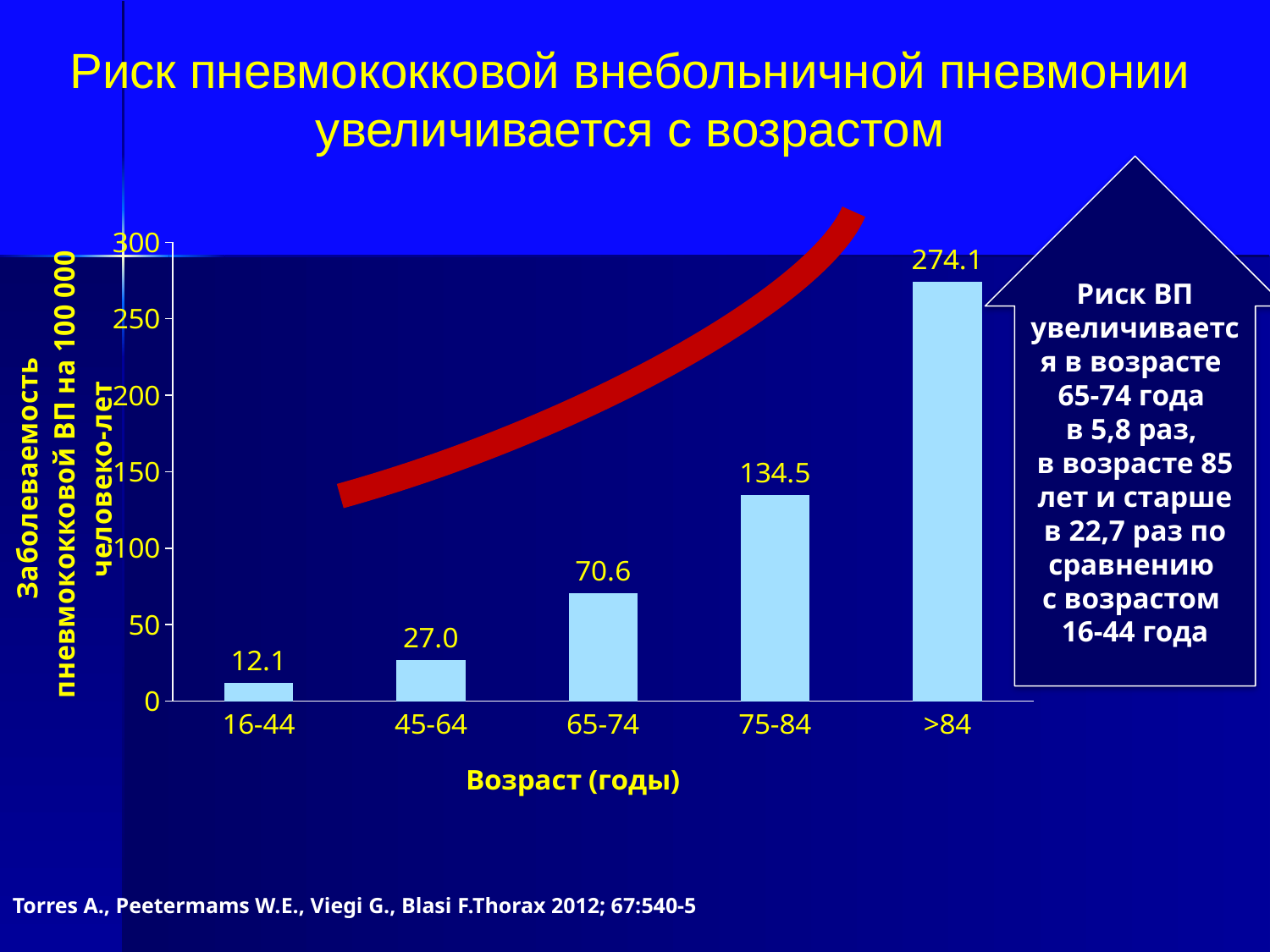
What is the difference between the values for 75-84 and 65-74? 63.9 Which age group has the highest value? >84 Which age group has the lowest value? 16-44 Do the values rise or fall as age increases along the x axis? rise What is the value for the 16-44 age group? 12.1 What is the value for the >84 age group? 274.1 What kind of chart is shown? bar chart What is the difference between the values for 45-64 and 16-44? 14.9 Which is larger, the value for 75-84 or the value for 65-74? 75-84 What is the value for the 65-74 age group? 70.6 How many age groups are shown on the x axis? 5 Is the value for >84 greater or less than 250? greater